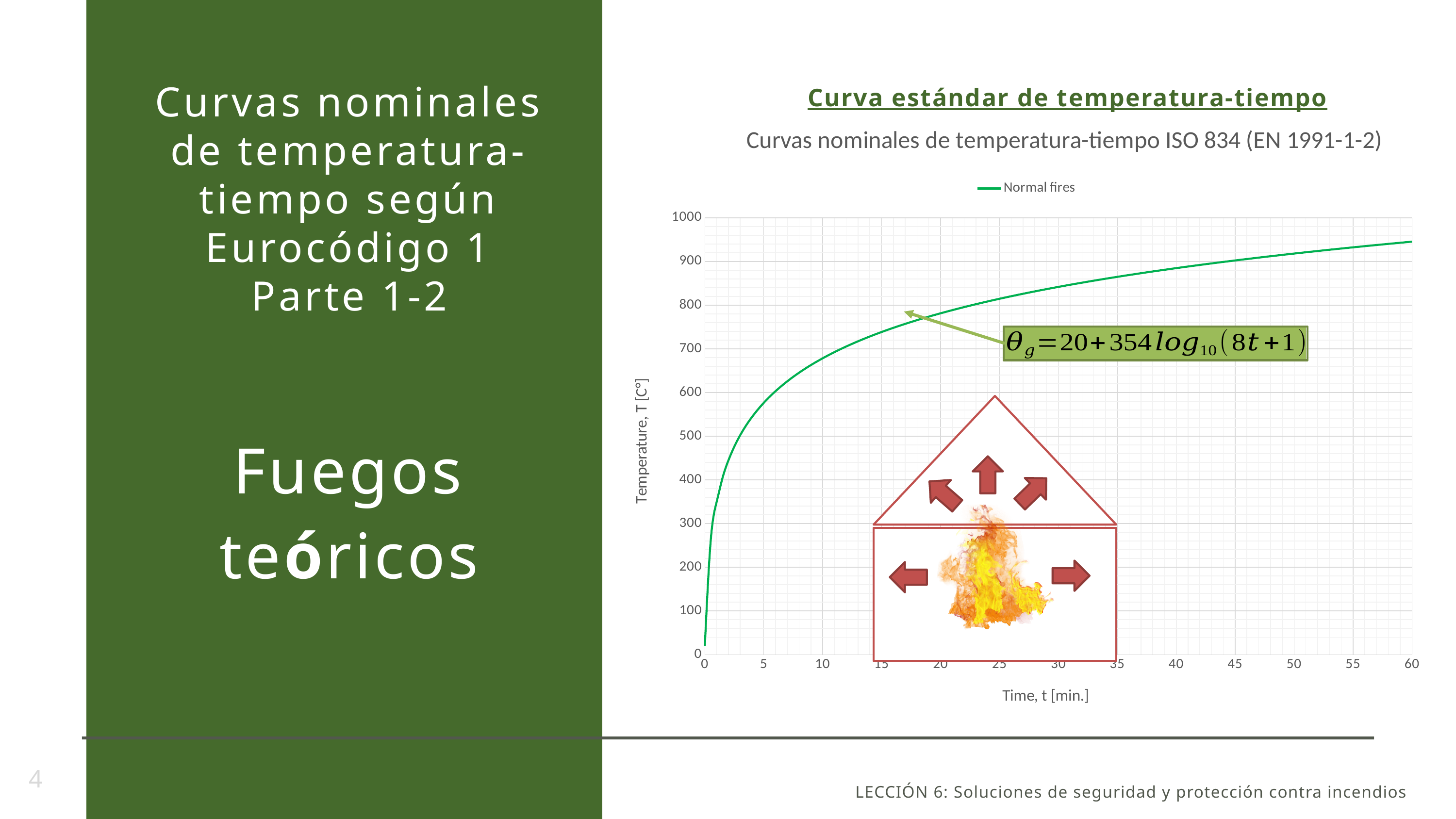
Does the temperature rise or fall as time increases along the x axis? rise What is the name of the series shown in the chart legend? Normal fires Is the temperature at 20 minutes greater or less than 700? greater How many series does the chart legend list? 1 At which time value on the x axis is the temperature lowest? 0 Is the temperature at 10 minutes greater or less than 800? less What kind of chart is shown on the slide? line chart At which time value on the x axis does the curve reach its highest temperature? 60 Is the temperature at 60 minutes greater or less than 900? greater What is the title of the chart? Curvas nominales de temperatura-tiempo ISO 834 (EN 1991-1-2)